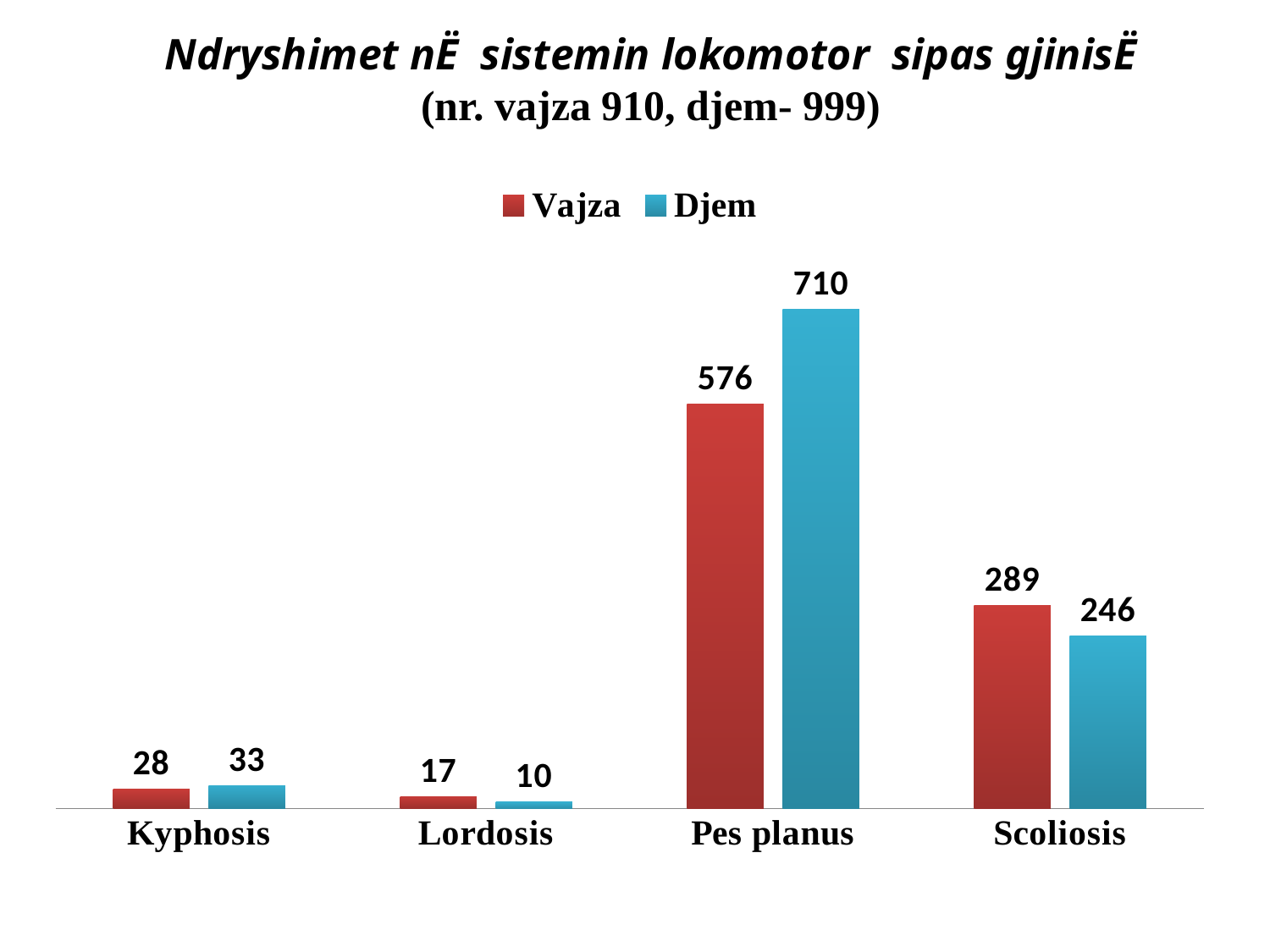
For Lordosis, which is larger, the Vajza value or the Djem value? Vajza How many series does the legend list? 2 How many categories are shown on the x axis? 4 What is the Djem value for Scoliosis? 246 What is the Vajza value for Pes planus? 576 What is the Vajza value for Lordosis? 17 What kind of chart is shown on the slide? Bar chart What is the Djem value for Kyphosis? 33 What is the difference between the Djem and Vajza values for Pes planus? 134 Which category has the lowest Vajza value? Lordosis Which category has the highest Djem value? Pes planus What is the difference between the Vajza and Djem values for Scoliosis? 43